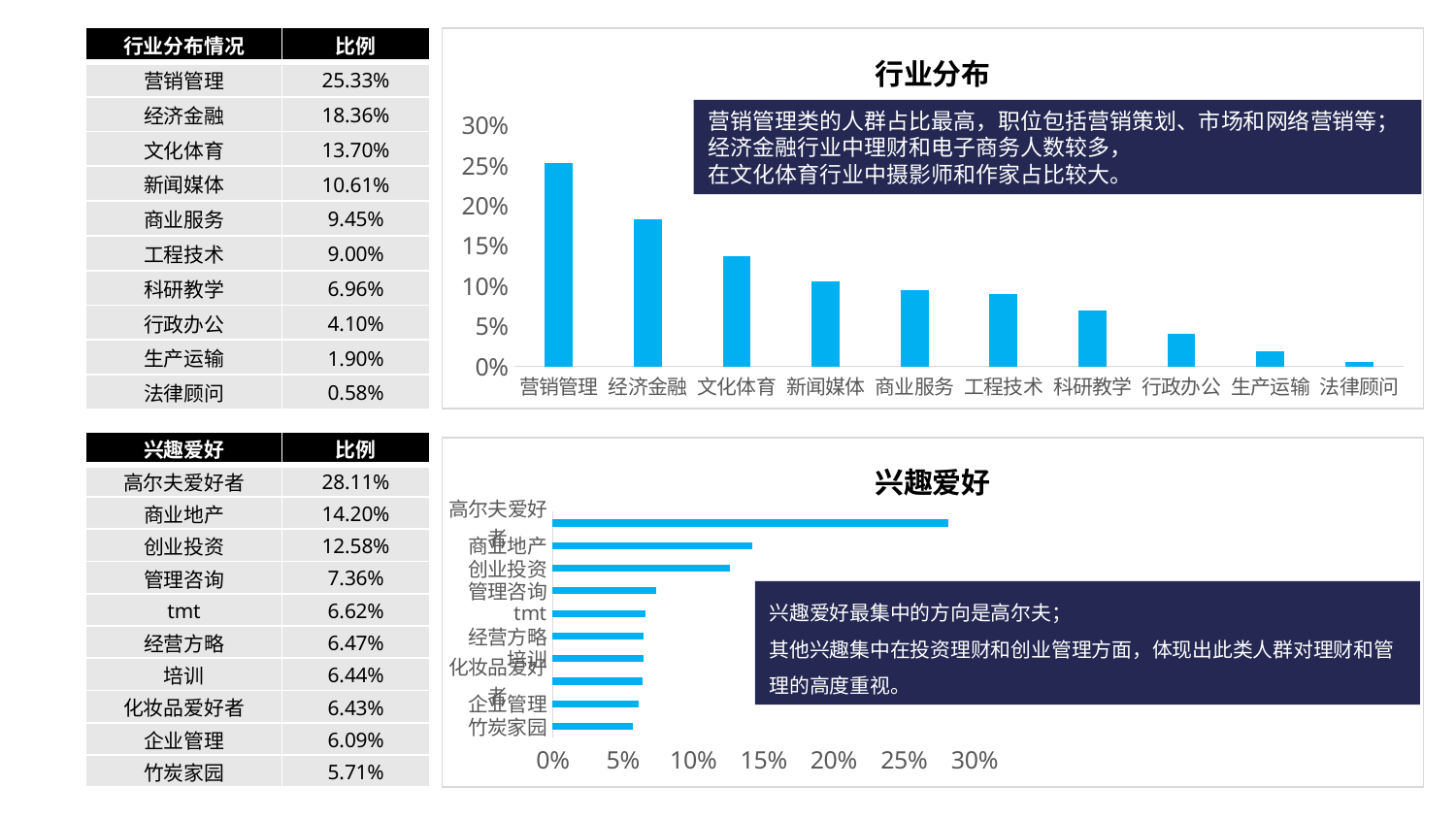
In the 行业分布 chart, what is the value for 营销管理? 25.33% In the 行业分布 chart, do the values rise or fall from left to right along the x axis? fall In the 兴趣爱好 chart, what is the value for 高尔夫爱好者? 28.11% In the 行业分布 chart, is the value for 经济金融 greater or less than 15%? greater How many categories are shown in the 行业分布 chart? 10 What kind of chart is the 兴趣爱好 chart? bar chart What kind of chart is the 行业分布 chart? bar chart In the 行业分布 chart, which is larger, 文化体育 or 新闻媒体? 文化体育 In the 行业分布 chart, which category has the highest value? 营销管理 How many categories are shown in the 兴趣爱好 chart? 10 In the 行业分布 chart, which category has the lowest value? 法律顾问 In the 兴趣爱好 chart, is the value for 管理咨询 greater or less than 10%? less